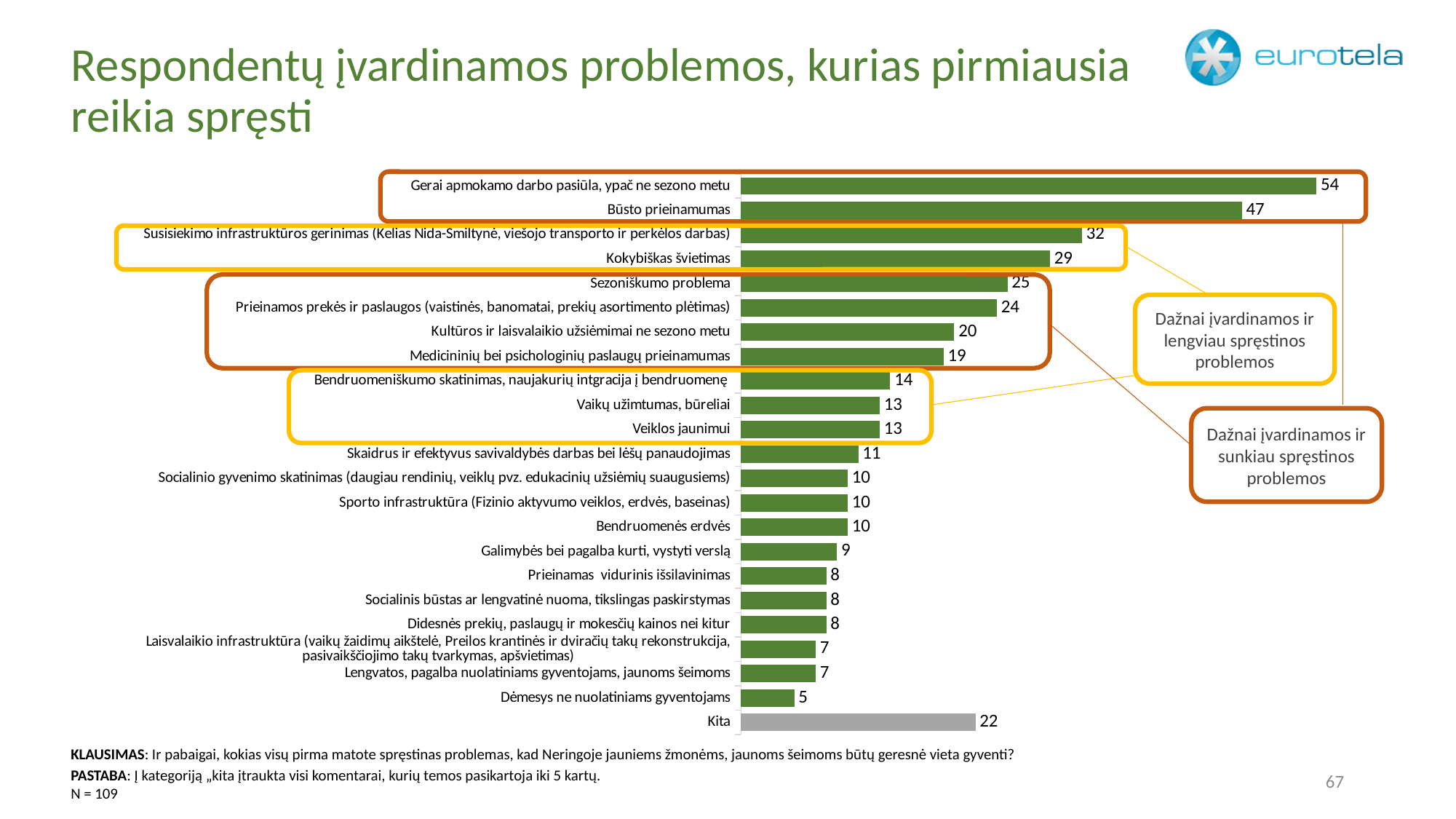
What kind of chart is shown on the slide? Bar chart How many categories are shown in the chart? 23 What is the difference between the values for "Sezoniškumo problema" and "Medicininių bei psichologinių paslaugų prieinamumas"? 6 What is the difference between the values for "Gerai apmokamo darbo pasiūla, ypač ne sezono metu" and "Būsto prieinamumas"? 7 Which category has the highest value? Gerai apmokamo darbo pasiūla, ypač ne sezono metu What is the value for "Kokybiškas švietimas"? 29 Which category has the lowest value? Dėmesys ne nuolatiniams gyventojams What is the value for "Kita"? 22 What is the value for "Būsto prieinamumas"? 47 Which bar is shown in grey rather than green? Kita What is the value for "Dėmesys ne nuolatiniams gyventojams"? 5 Which is larger: the value for "Kultūros ir laisvalaikio užsiėmimai ne sezono metu" or the value for "Bendruomeniškumo skatinimas, naujakurių intgracija į bendruomenę"? Kultūros ir laisvalaikio užsiėmimai ne sezono metu